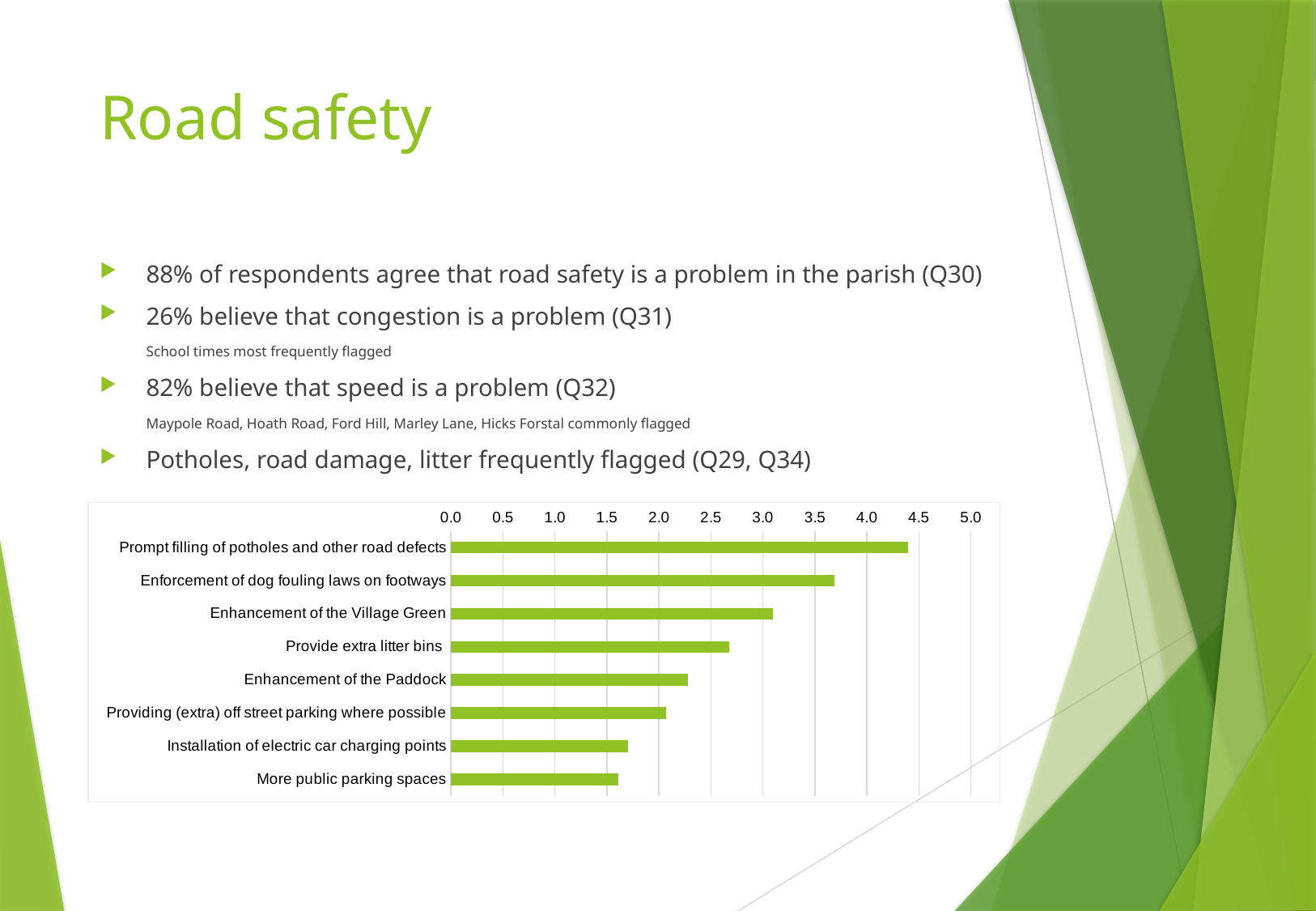
Is the value for Enhancement of the Paddock greater or less than 2.0? greater Is the value for More public parking spaces greater or less than 2.0? less What kind of chart is shown on the slide? bar chart Which category has the highest value in the bar chart? Prompt filling of potholes and other road defects How many categories are plotted in the bar chart? 8 Is the value for Enforcement of dog fouling laws on footways greater or less than 3.5? greater Which has the larger value: Enhancement of the Village Green or Provide extra litter bins? Enhancement of the Village Green What is the highest value shown on the chart's axis? 5.0 Do the bar values increase or decrease going from the top category to the bottom category? decrease